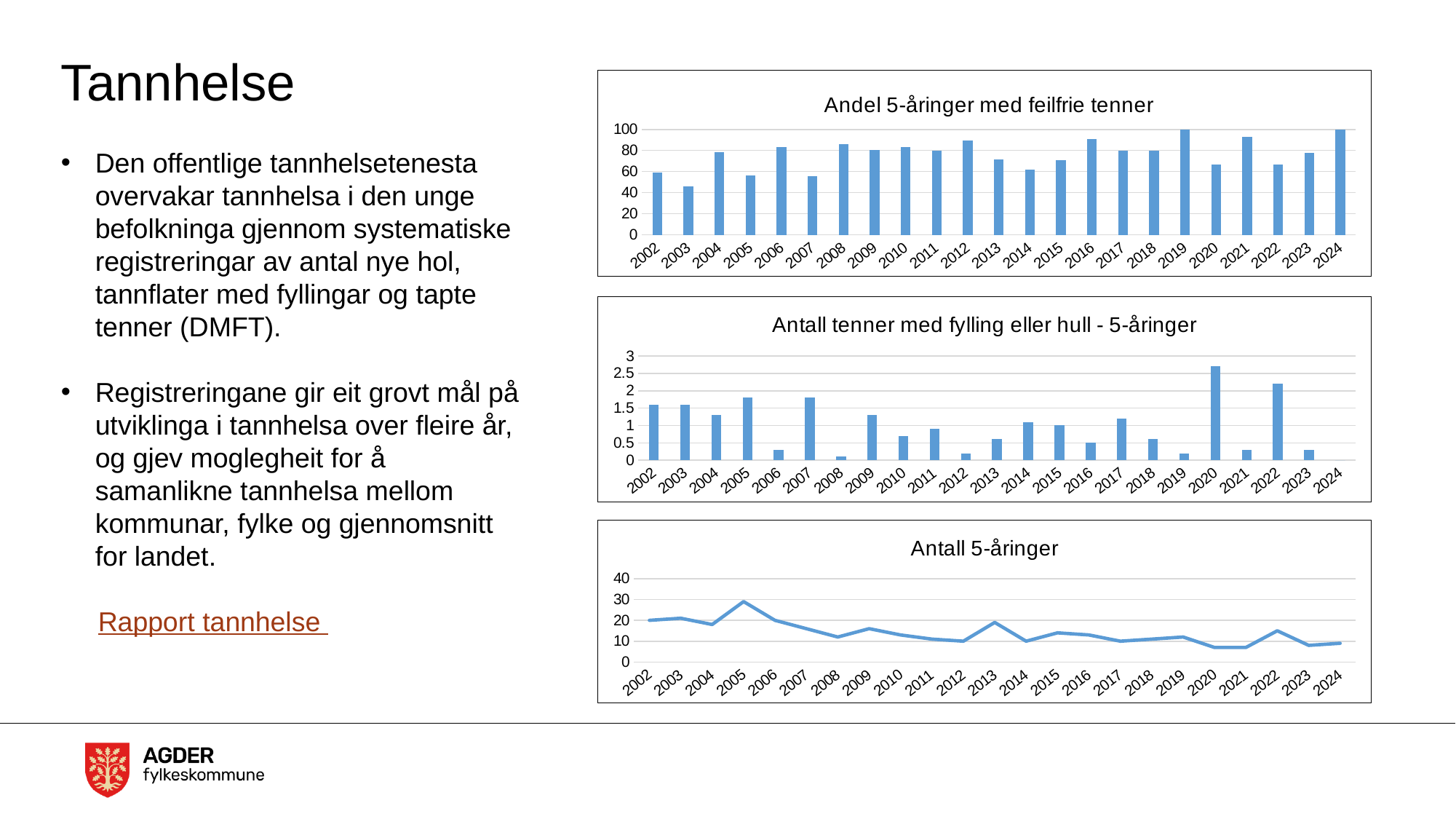
In the 'Antall tenner med fylling eller hull - 5-åringer' chart, which is larger, the value for 2020 or the value for 2022? 2020 In the 'Antall tenner med fylling eller hull - 5-åringer' chart, is the value for 2020 greater or less than 2.5? greater What kind of chart is the 'Antall 5-åringer' chart? line chart In the 'Antall 5-åringer' chart, do the values generally rise or fall from 2002 to 2024? fall In the 'Andel 5-åringer med feilfrie tenner' chart, which year has the lowest value? 2003 What kind of chart is the 'Andel 5-åringer med feilfrie tenner' chart? bar chart In the 'Andel 5-åringer med feilfrie tenner' chart, is the value for 2003 greater or less than 60? less In the 'Antall tenner med fylling eller hull - 5-åringer' chart, which year has the highest value? 2020 In the 'Antall 5-åringer' chart, which year has the highest value? 2005 In the 'Andel 5-åringer med feilfrie tenner' chart, is the value for 2014 greater or less than 80? less How many years are shown on the x axis of the 'Andel 5-åringer med feilfrie tenner' chart? 23